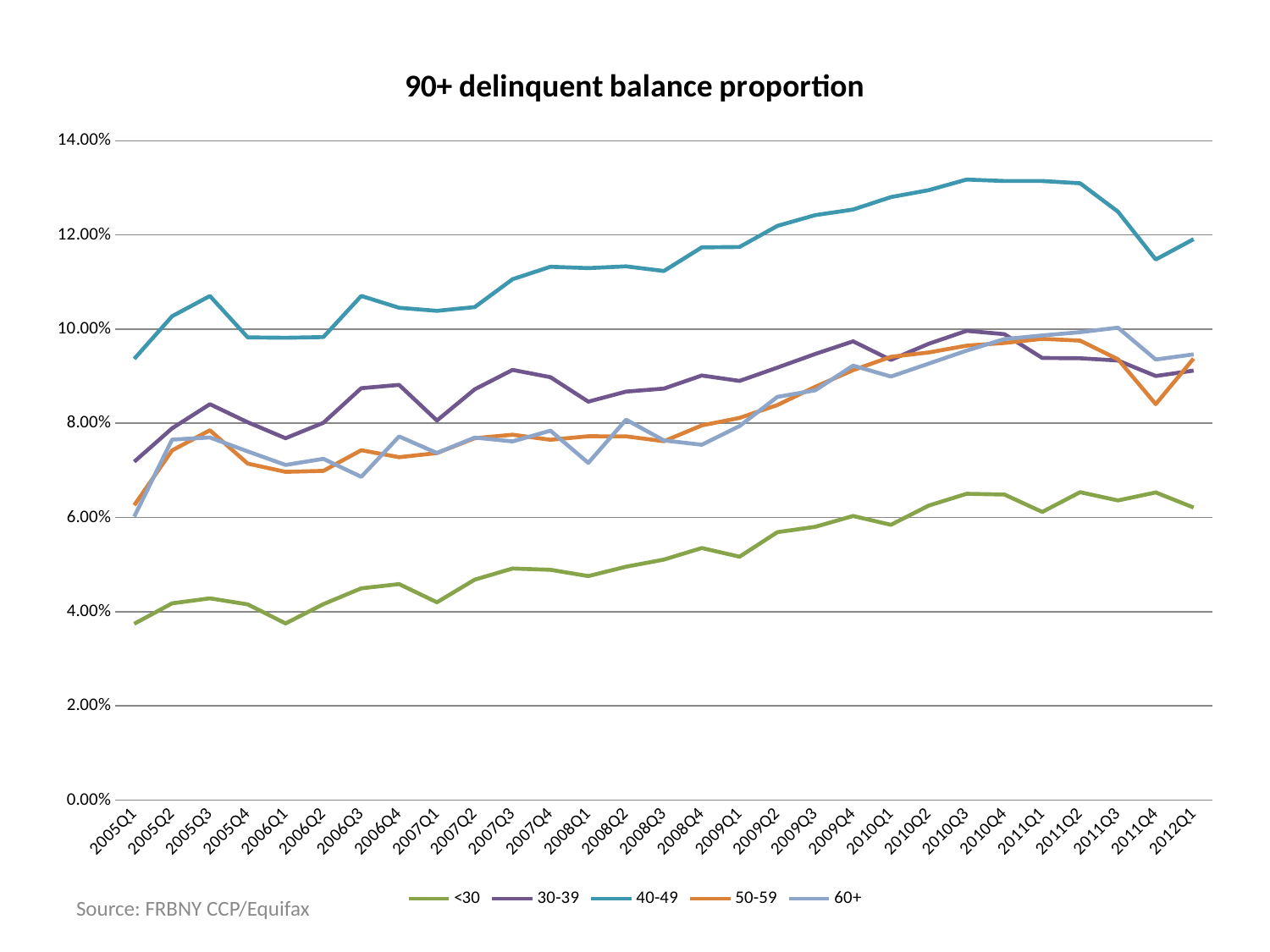
What is the title of the chart? 90+ delinquent balance proportion Is the value for the 40-49 group in 2010Q3 greater or less than 12.00%? greater Is the value for the <30 group in 2005Q1 greater or less than 4.00%? less What type of chart is shown on the slide? line chart Is the value for the 40-49 group in 2005Q1 greater or less than 10.00%? less How many quarters are plotted along the x axis? 29 Does the 40-49 line generally rise or fall from 2005Q1 to 2010Q3? rise How many series does the legend list? 5 In 2012Q1, which is larger: the value for the 40-49 group or the <30 group? 40-49 Which age group has the lowest 90+ delinquent balance proportion across the whole period? <30 Which age group has the highest 90+ delinquent balance proportion across the whole period? 40-49